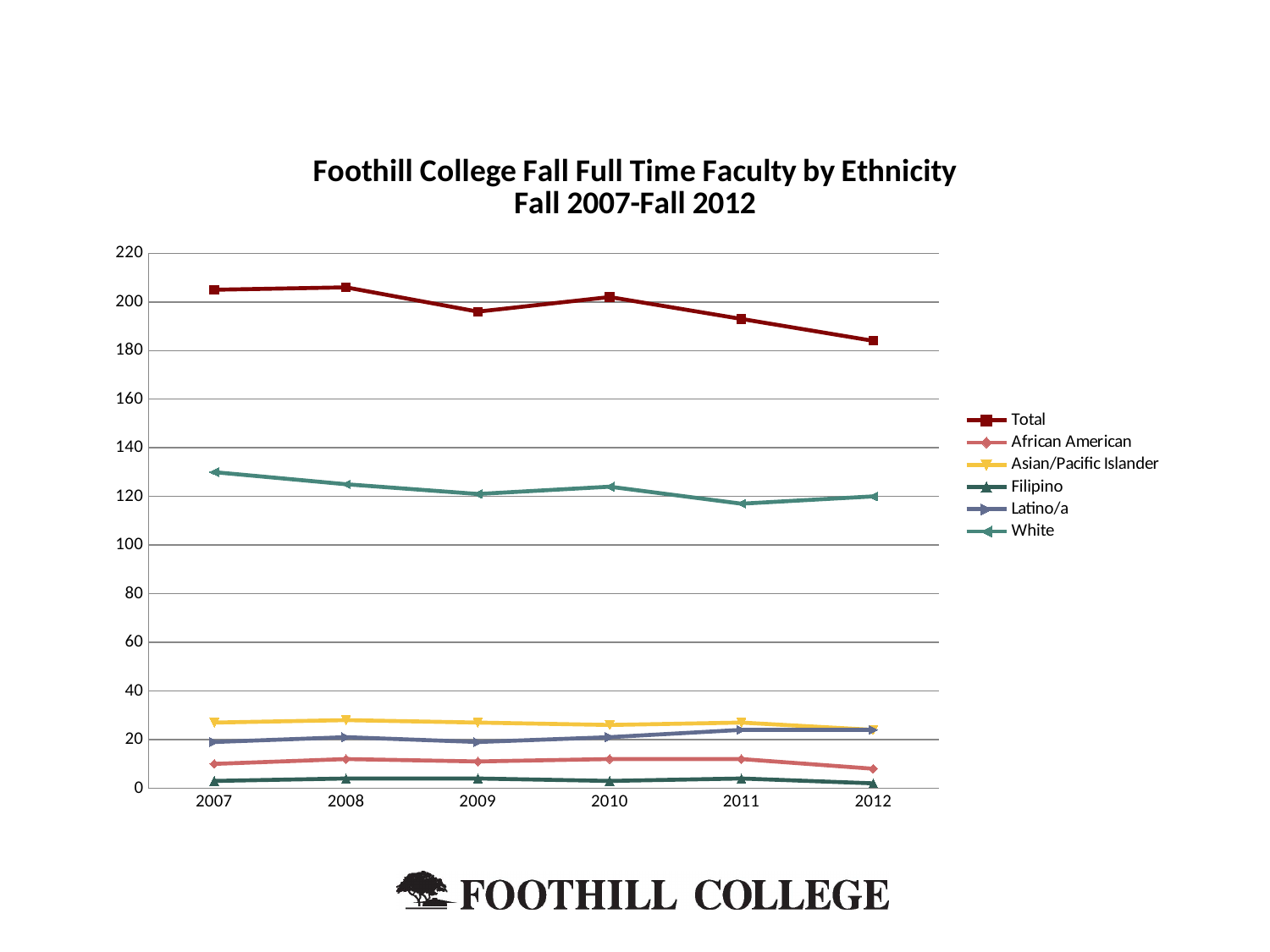
Is the value for White in 2007 greater or less than 120? greater In which year is the Total series at its lowest? 2012 Is the value for Asian/Pacific Islander in 2008 greater or less than 20? greater How many years are plotted along the x axis? 6 What is the title of the chart? Foothill College Fall Full Time Faculty by Ethnicity Fall 2007-Fall 2012 What kind of chart is shown on the slide? line chart Which series has the lowest values across all years? Filipino Is the value for Total in 2012 greater or less than 200? less In which year is the White series at its highest? 2007 In 2010, which is larger: Latino/a or African American? Latino/a How many series does the legend list? 6